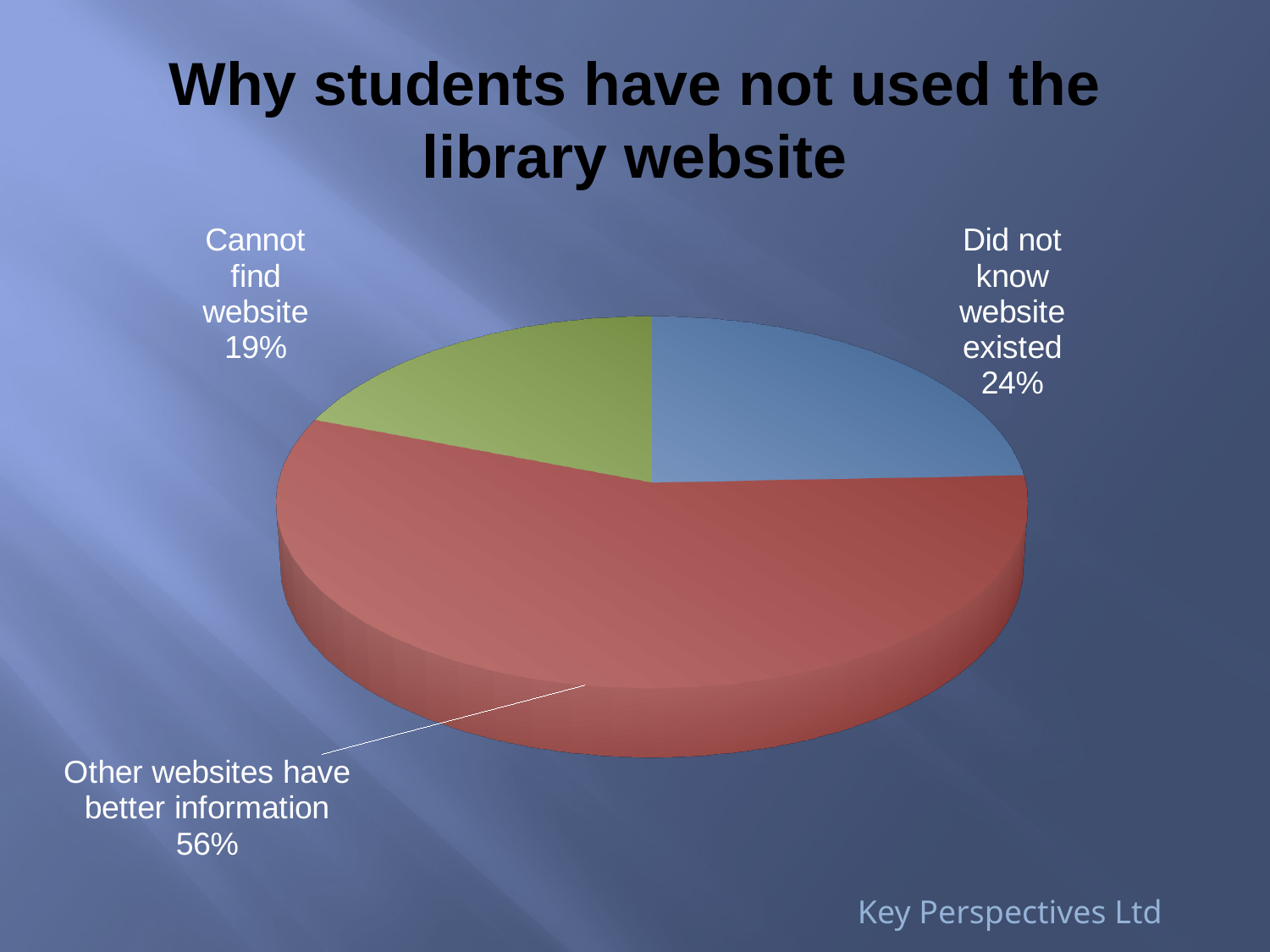
What percentage of students did not know the website existed? 24% Which reason has the smallest share of the pie? Cannot find website Which reason has the largest share of the pie? Other websites have better information What is the difference in percentage points between 'Did not know website existed' and 'Cannot find website'? 5 What colour is the slice for 'Other websites have better information'? Red What is the title of the chart? Why students have not used the library website What percentage of students cannot find the website? 19% What is the difference in percentage points between 'Other websites have better information' and 'Did not know website existed'? 32 Which is larger: the share for 'Did not know website existed' or 'Cannot find website'? Did not know website existed How many slices does the pie chart have? 3 What percentage of students said other websites have better information? 56% What kind of chart is shown on the slide? Pie chart